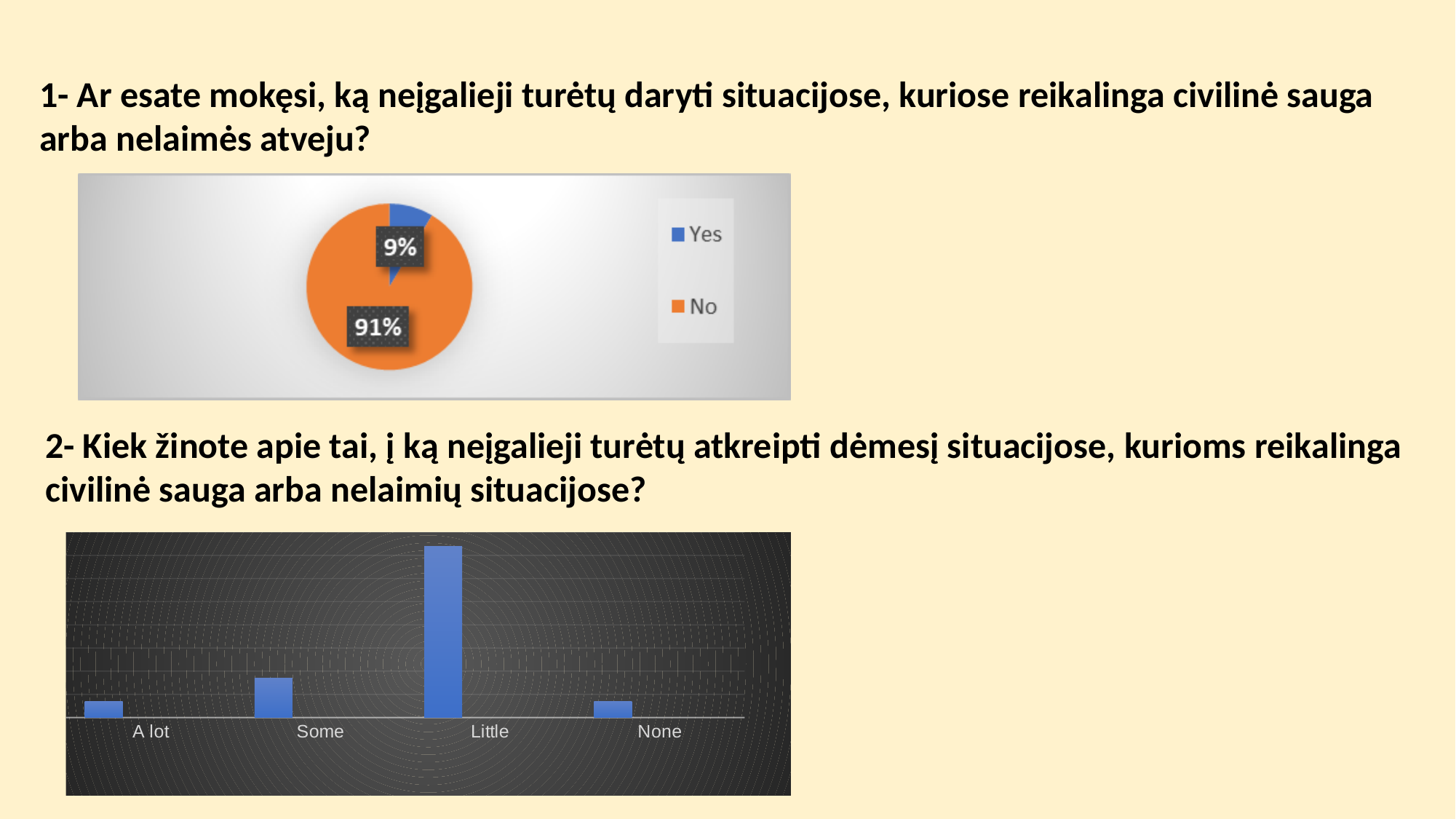
In the bottom bar chart, which category has the highest bar? Little In the top pie chart, what percentage of respondents answered "No"? 91% How many entries does the legend of the top pie chart list? 2 In the top pie chart, by how many percentage points does "No" exceed "Yes"? 82 percentage points What type of chart is the top chart on the slide? Pie chart In the top pie chart, which answer has the largest share? No How many categories are shown in the bottom bar chart? 4 In the top pie chart, which colour represents "No"? Orange What type of chart is the bottom chart on the slide? Bar chart In the bottom bar chart, which is larger, the bar for "Some" or the bar for "A lot"? Some In the top pie chart, what percentage of respondents answered "Yes"? 9% In the top pie chart, which answer has the smallest share? Yes